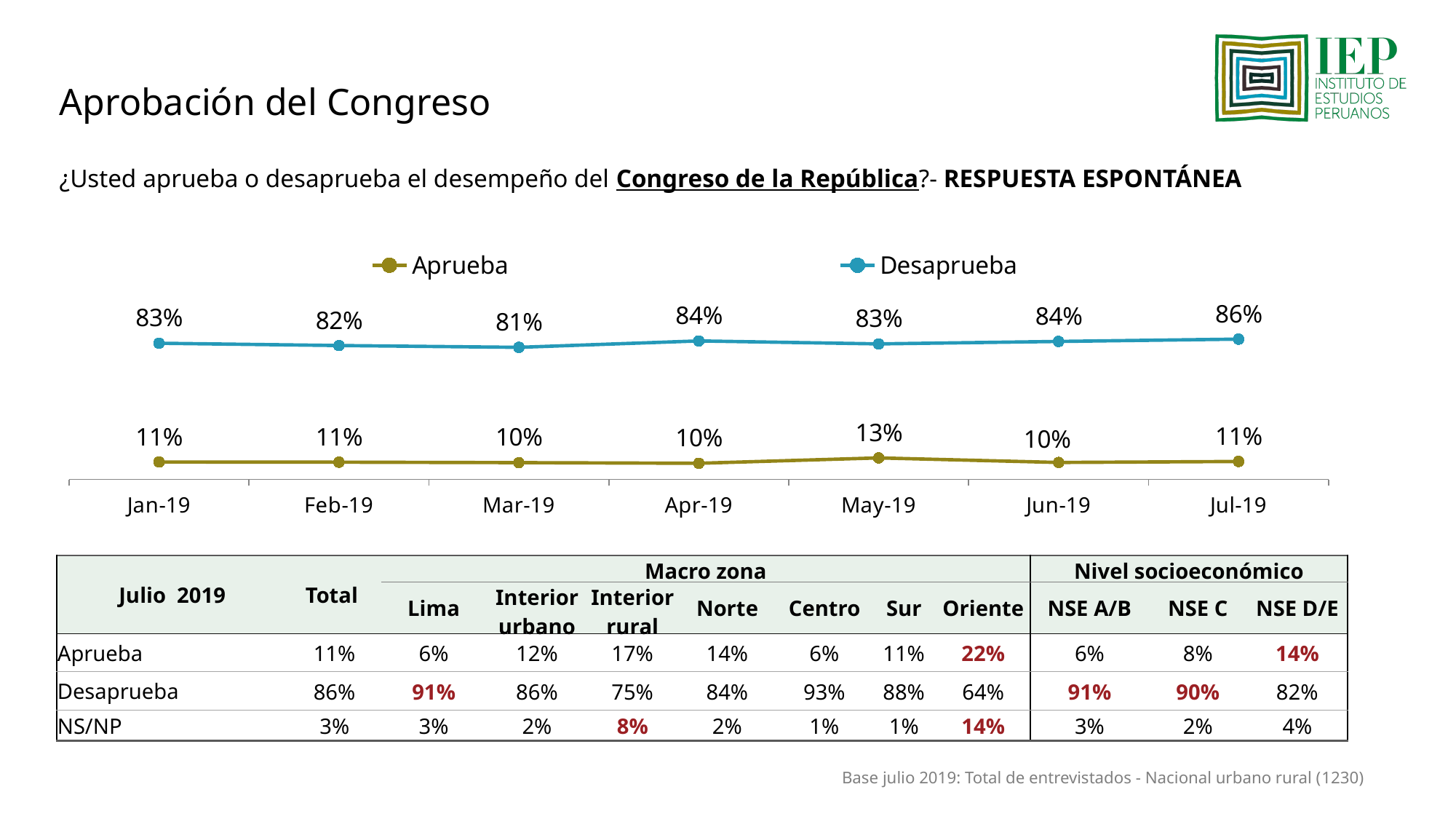
What is the difference between the Desaprueba and Aprueba values in Jul-19? 75% Which is larger in Apr-19, the Desaprueba value or the Aprueba value? Desaprueba How many series does the legend list? 2 What is the Desaprueba value for Jul-19? 86% What is the difference between the Desaprueba values in Jul-19 and Mar-19? 5% In which month is the Desaprueba series highest? Jul-19 What is the Aprueba value for May-19? 13% In which month is the Aprueba series highest? May-19 In which month is the Desaprueba series lowest? Mar-19 What kind of chart is shown on the slide? Line chart What is the Desaprueba value for Mar-19? 81% How many months are plotted on the x axis? 7